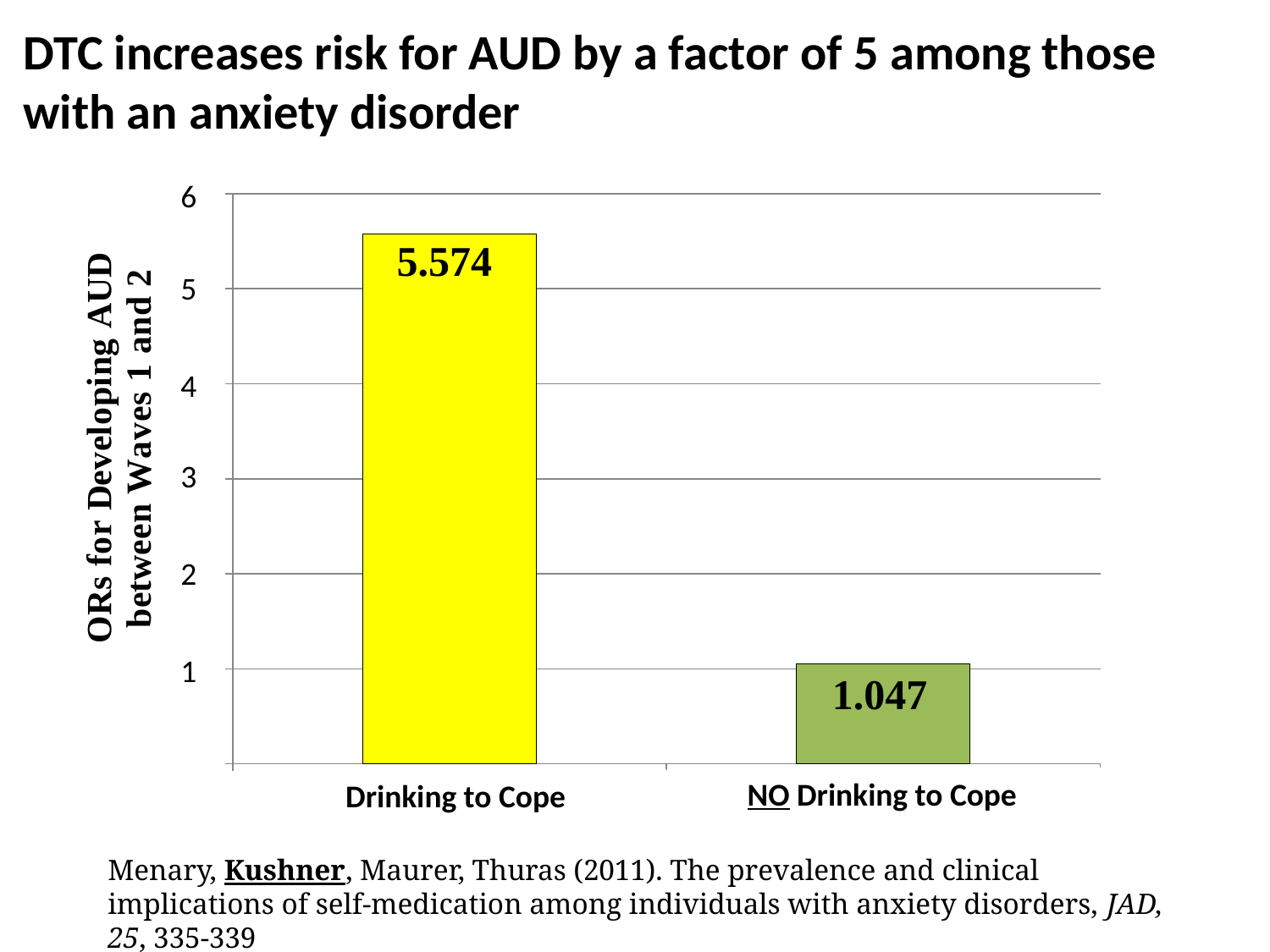
How many categories are shown on the x axis of the chart? 2 What is the difference between the odds ratios for Drinking to Cope and NO Drinking to Cope? 4.527 Which category has the highest odds ratio for developing AUD? Drinking to Cope What is the odds ratio for developing AUD for the NO Drinking to Cope group? 1.047 Which category has the lowest odds ratio for developing AUD? NO Drinking to Cope Which is larger, the odds ratio for Drinking to Cope or for NO Drinking to Cope? Drinking to Cope What kind of chart is shown on the slide? Bar chart Is the odds ratio for Drinking to Cope greater or less than 5? greater Is the odds ratio for NO Drinking to Cope greater or less than 2? less What is the label of the vertical axis of the chart? ORs for Developing AUD between Waves 1 and 2 What is the odds ratio for developing AUD for the Drinking to Cope group? 5.574 What colour is the bar for Drinking to Cope? Yellow